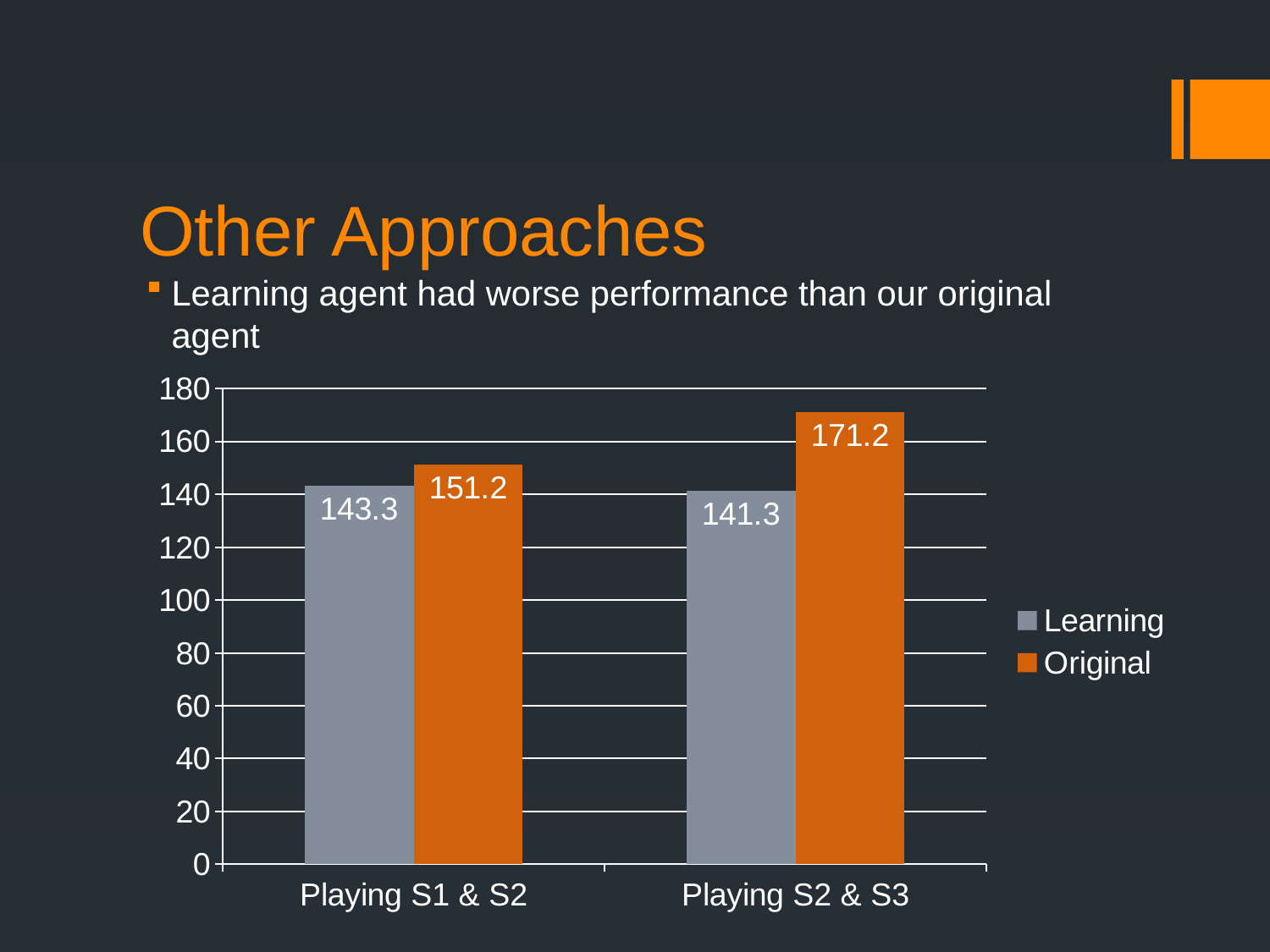
What is the value for Original when Playing S2 & S3? 171.2 Which bar has the highest value in the chart? Original, Playing S2 & S3 Which bar has the lowest value in the chart? Learning, Playing S2 & S3 Which is larger when Playing S1 & S2, Learning or Original? Original How many series does the legend list? 2 How many categories are shown on the x axis? 2 What is the value for Learning when Playing S1 & S2? 143.3 What kind of chart is shown on the slide? Bar chart What is the value for Original when Playing S1 & S2? 151.2 What is the value for Learning when Playing S2 & S3? 141.3 What is the difference between the Original and Learning values when Playing S2 & S3? 29.9 What is the difference between the Original and Learning values when Playing S1 & S2? 7.9